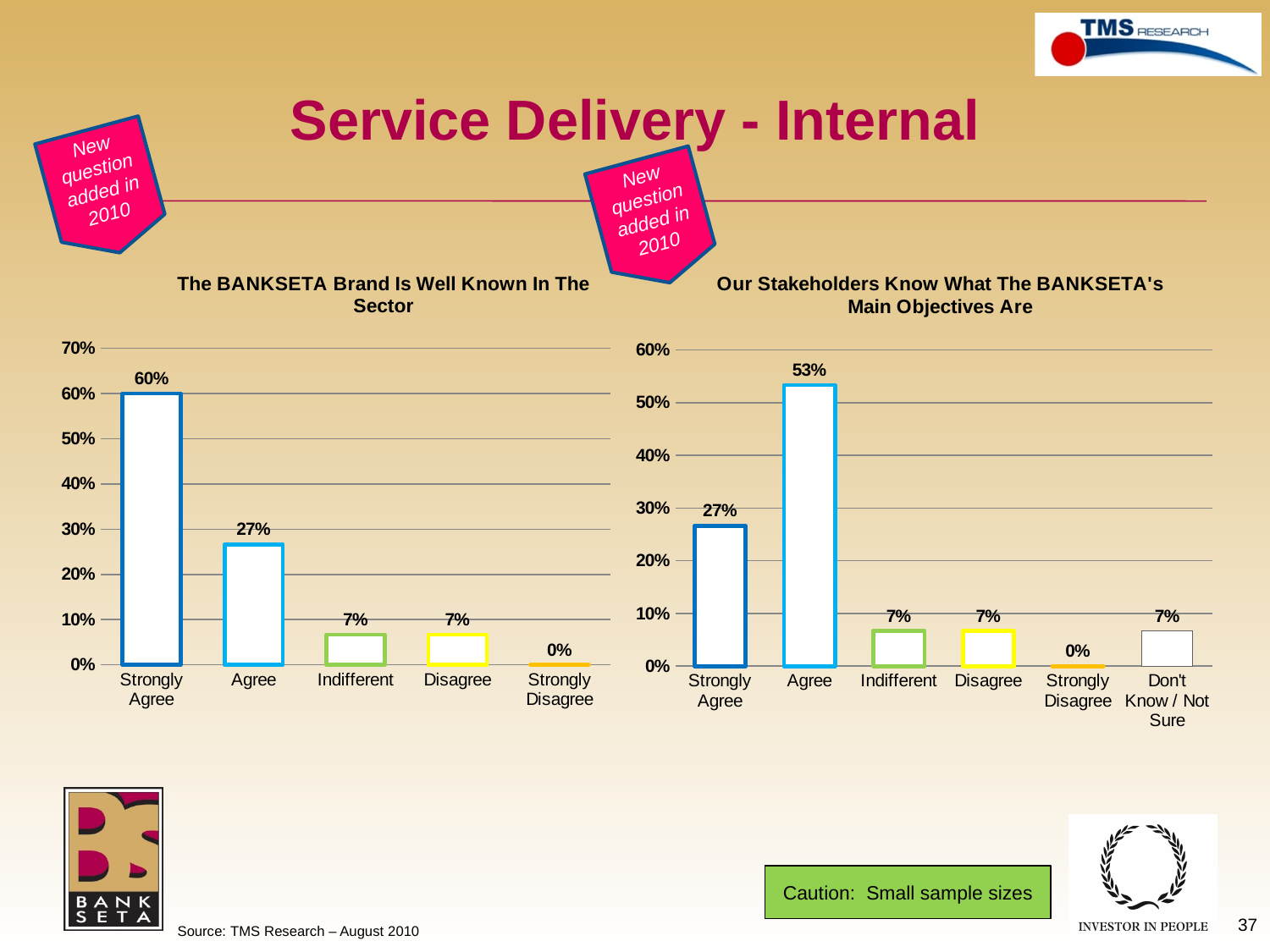
In the chart 'Our Stakeholders Know What The BANKSETA's Main Objectives Are', what is the value for Agree? 53% In the chart 'Our Stakeholders Know What The BANKSETA's Main Objectives Are', which is larger, Strongly Agree or Agree? Agree In the chart 'The BANKSETA Brand Is Well Known In The Sector', what is the value for Strongly Agree? 60% In the chart 'The BANKSETA Brand Is Well Known In The Sector', what is the value for Agree? 27% What kind of chart is 'The BANKSETA Brand Is Well Known In The Sector'? Bar chart In the chart 'The BANKSETA Brand Is Well Known In The Sector', which category has the lowest value? Strongly Disagree In the chart 'Our Stakeholders Know What The BANKSETA's Main Objectives Are', what is the difference between Agree and Strongly Agree? 26% In the chart 'Our Stakeholders Know What The BANKSETA's Main Objectives Are', what is the value for Don't Know / Not Sure? 7% In the chart 'The BANKSETA Brand Is Well Known In The Sector', which category has the highest value? Strongly Agree In the chart 'Our Stakeholders Know What The BANKSETA's Main Objectives Are', which category has the highest value? Agree In the chart 'The BANKSETA Brand Is Well Known In The Sector', what is the difference between Strongly Agree and Agree? 33% How many categories are shown in the chart 'Our Stakeholders Know What The BANKSETA's Main Objectives Are'? 6